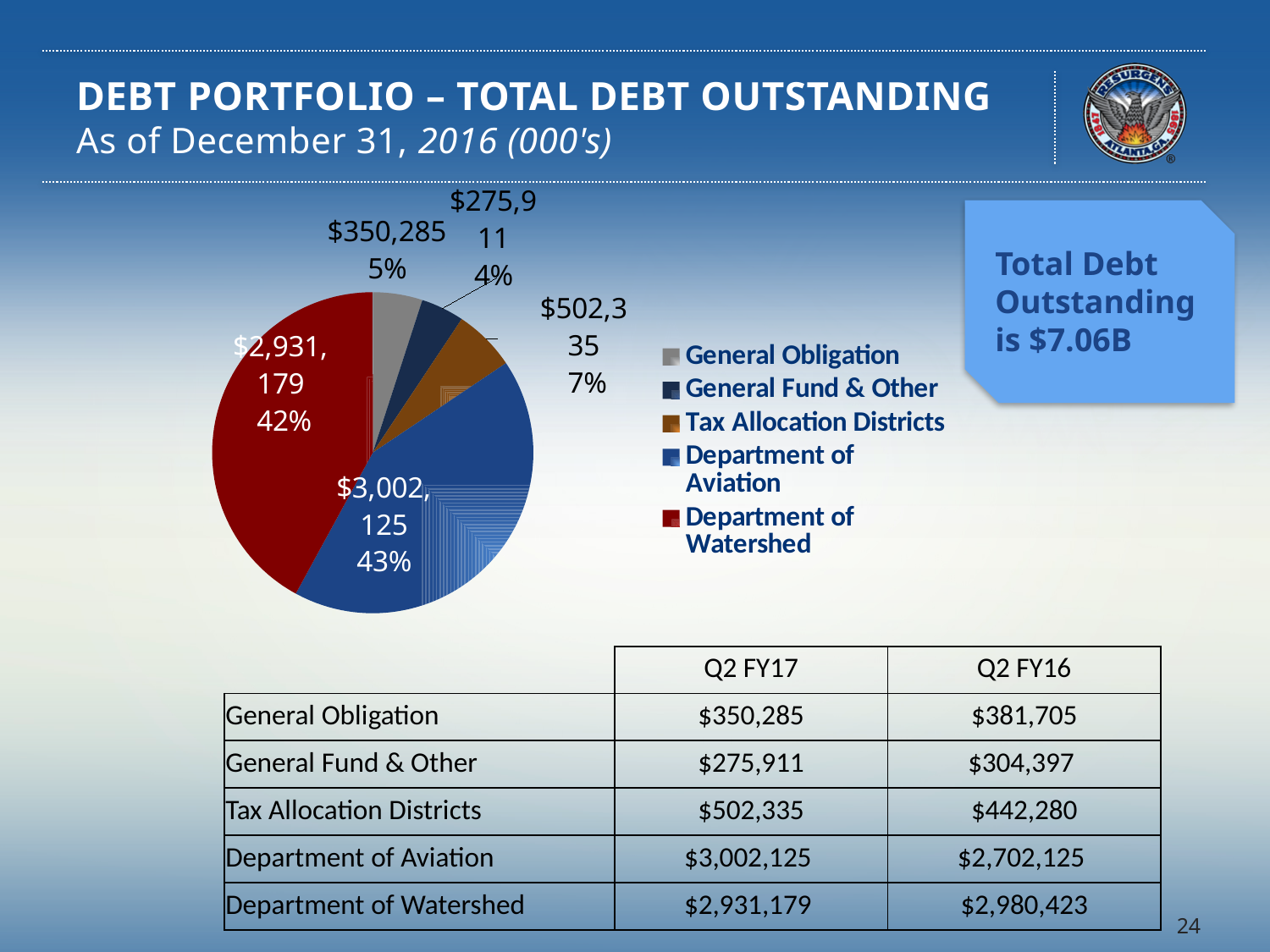
What kind of chart is shown on the slide? pie chart How many slices does the pie chart have? 5 What is the value shown for Tax Allocation Districts in the pie chart? $502,335 What is the difference between the Department of Aviation value and the Department of Watershed value in the pie chart? $70,946 What share of the pie does Department of Watershed represent? 42% How many entries does the pie chart legend list? 5 What share of the pie does Department of Aviation represent? 43% Which is larger in the pie chart, Tax Allocation Districts or General Obligation? Tax Allocation Districts What share of the pie does General Fund & Other represent? 4% Which category has the largest slice of the pie? Department of Aviation What is the value shown for General Obligation in the pie chart? $350,285 Which category has the smallest slice of the pie? General Fund & Other